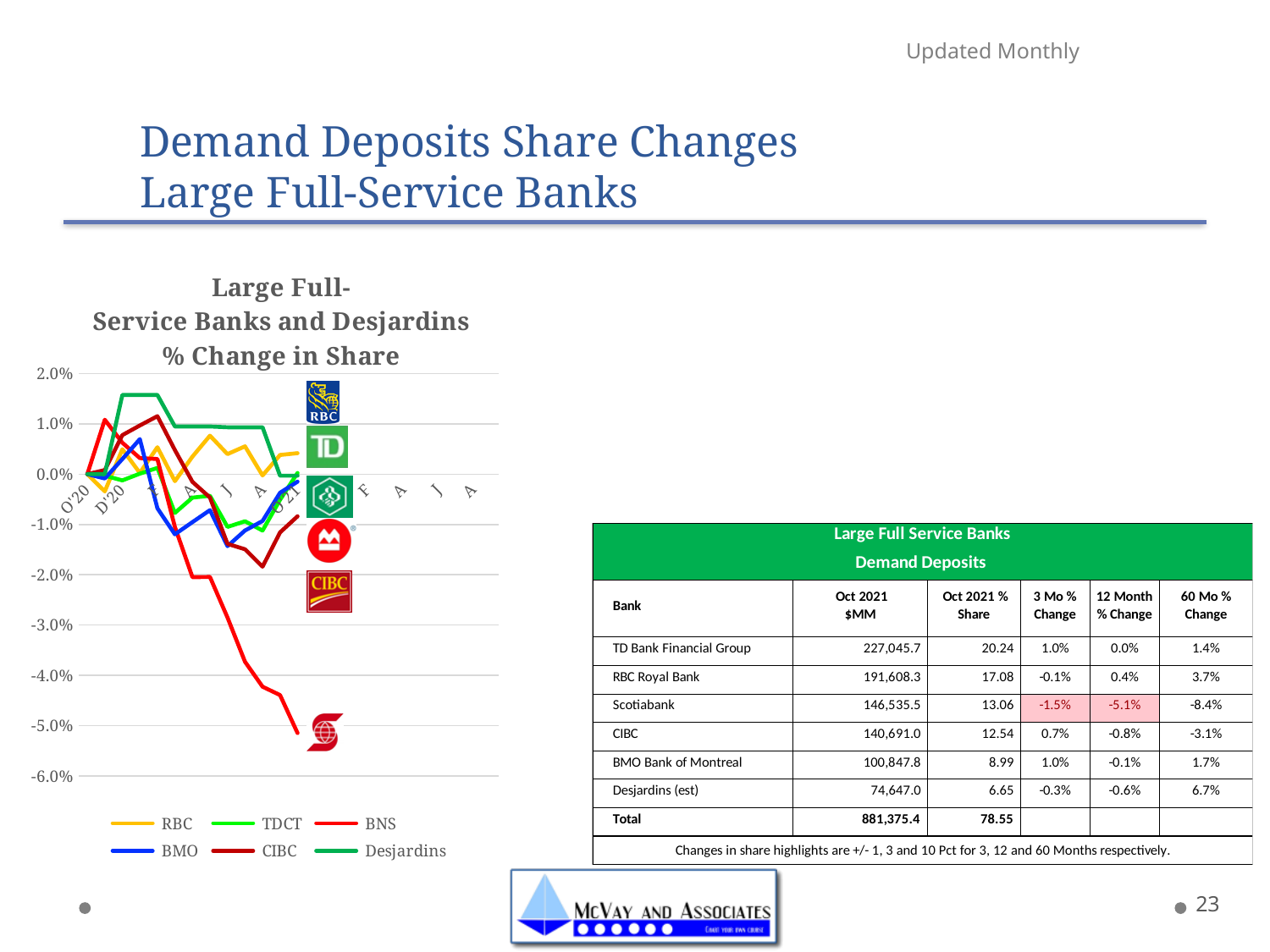
Is the lowest point of the BNS line greater or less than -6.0%? greater Is the final value of the BNS line greater or less than -4.0%? less What is the title of the line chart? Large Full-Service Banks and Desjardins % Change in Share How many series does the legend of the line chart list? 6 Which series in the line chart has the lowest value at the right end of the x axis? BNS What is the lowest tick value shown on the y axis of the line chart? -6.0% What is the highest tick value shown on the y axis of the line chart? 2.0% At the right end of the chart, which is larger: the BNS value or the RBC value? RBC What kind of chart is shown on the slide? line chart Does the BNS line rise or fall overall from left to right along the x axis? fall